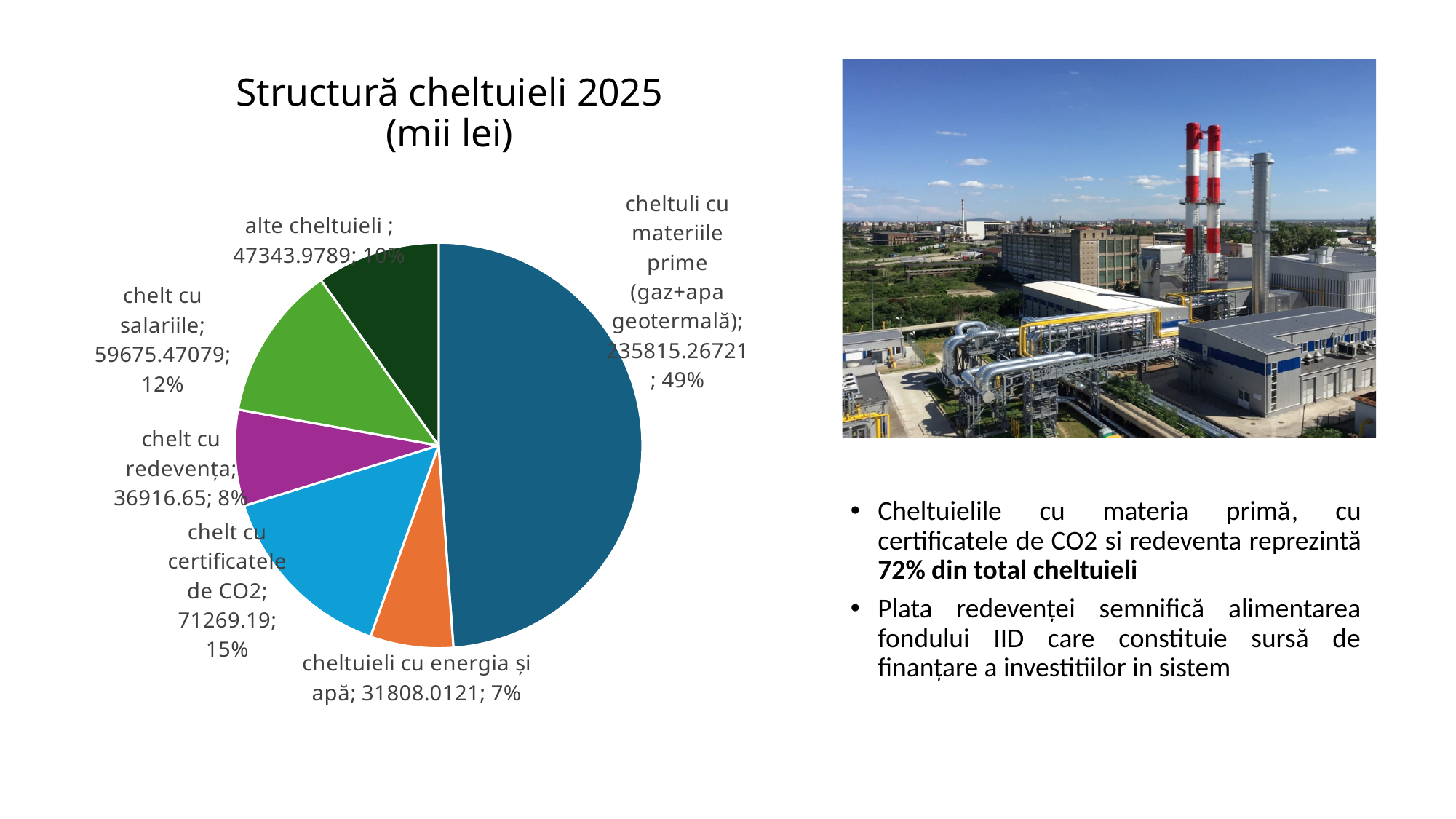
What is the title of the chart? Structură cheltuieli 2025 (mii lei) Which is larger, 'chelt cu salariile' or 'alte cheltuieli'? chelt cu salariile Which category has the largest slice? cheltuli cu materiile prime (gaz+apa geotermală) What is the value for 'chelt cu certificatele de CO2'? 71269.19 What type of chart is shown on the slide? pie chart What share of the pie does 'chelt cu redevența' represent? 8% What is the difference between the values for 'chelt cu redevența' and 'cheltuieli cu energia și apă'? 5108.6379 What is the value for 'chelt cu salariile'? 59675.47079 How many slices does the pie chart have? 6 Which category has the smallest slice? cheltuieli cu energia și apă What share of the pie does 'cheltuli cu materiile prime (gaz+apa geotermală)' represent? 49% What is the value for 'cheltuieli cu energia și apă'? 31808.0121